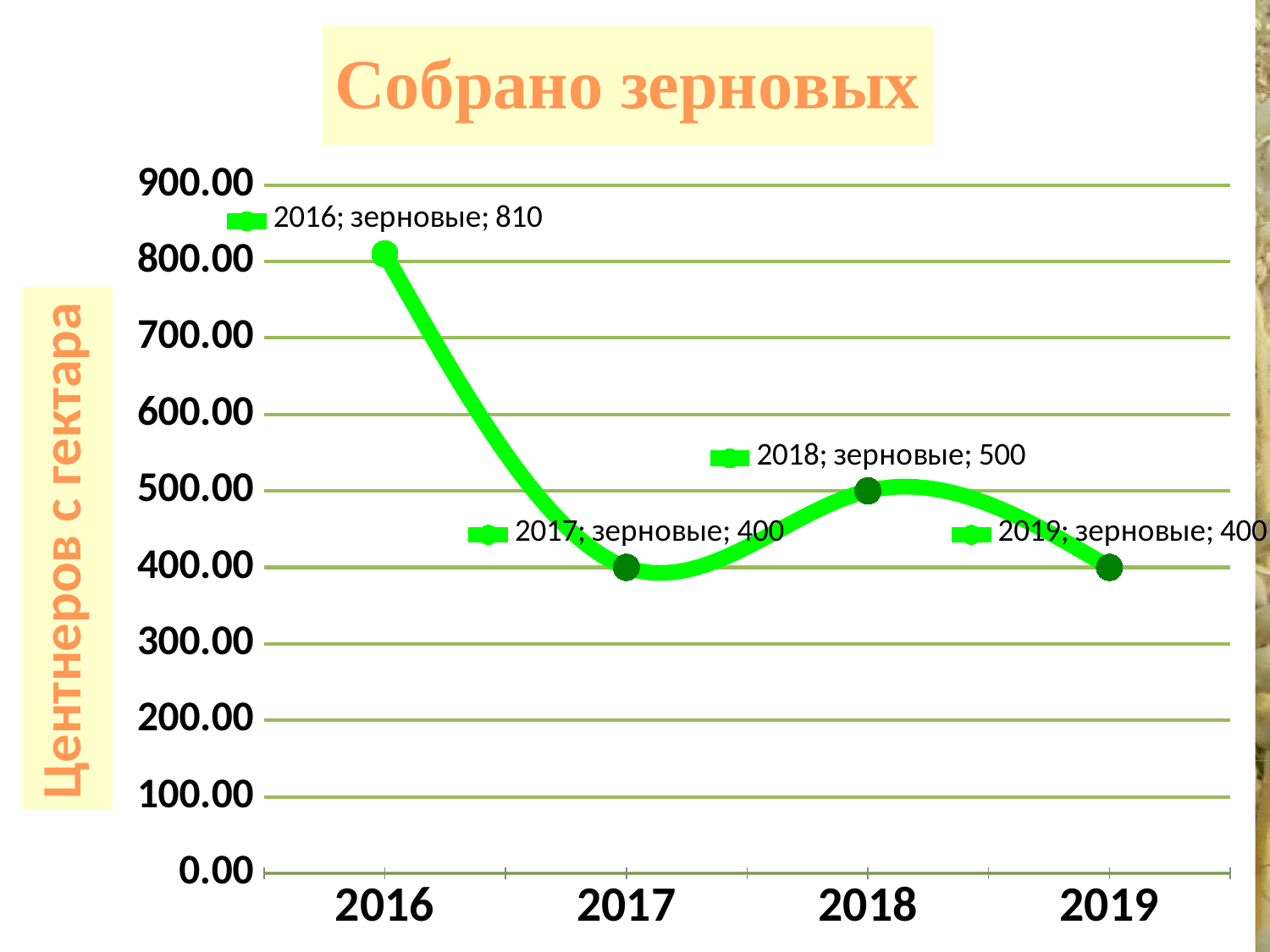
What is the difference between the values for 2016 and 2017? 410 What kind of chart is shown? line chart What is the value for 2017? 400 What is the value for 2016? 810 What is the title of the chart? Собрано зерновых Which is larger, the value for 2018 or the value for 2019? 2018 Is the value for 2016 greater or less than 700? greater What is the difference between the values for 2018 and 2019? 100 How many years are plotted on the chart? 4 Which year has the highest value? 2016 What is the value for 2018? 500 Does the value rise or fall from 2016 to 2017? fall